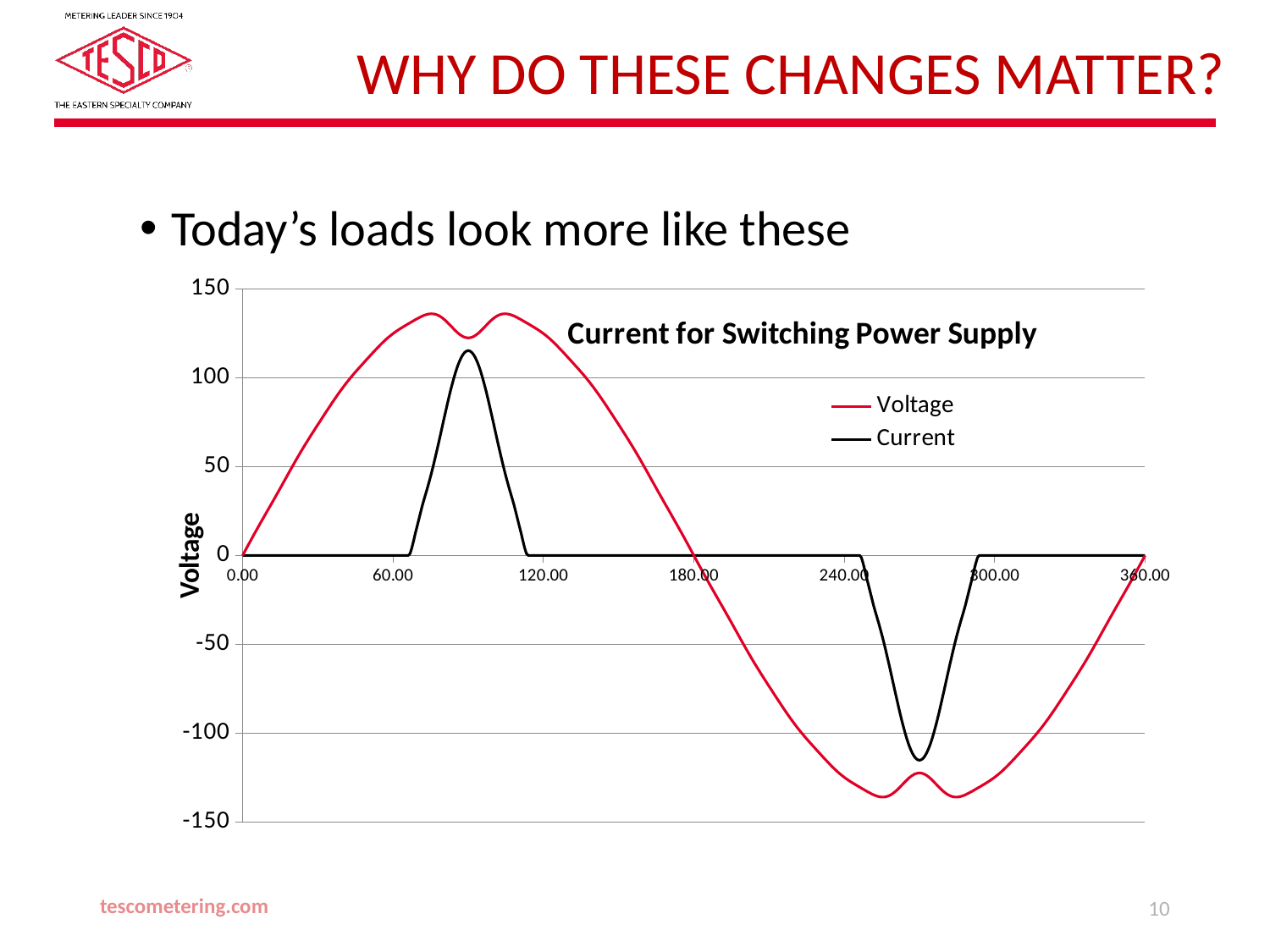
How many series does the chart legend list? 2 Does the Voltage series rise or fall between 120.00 and 180.00 on the x axis? Fall Is the peak value of the Voltage series greater or less than 100? greater Is the lowest value of the Voltage series greater or less than -100? less What is the value of the Voltage series at 180.00 on the x axis? 0 Is the peak value of the Current series greater or less than 100? greater Which series is drawn in red? Voltage What is the title of the chart? Current for Switching Power Supply Which series reaches a higher peak value, Voltage or Current? Voltage What kind of chart is shown on the slide? Line chart What is the value of the Current series at 60.00 on the x axis? 0 What is the value of the Current series at 180.00 on the x axis? 0